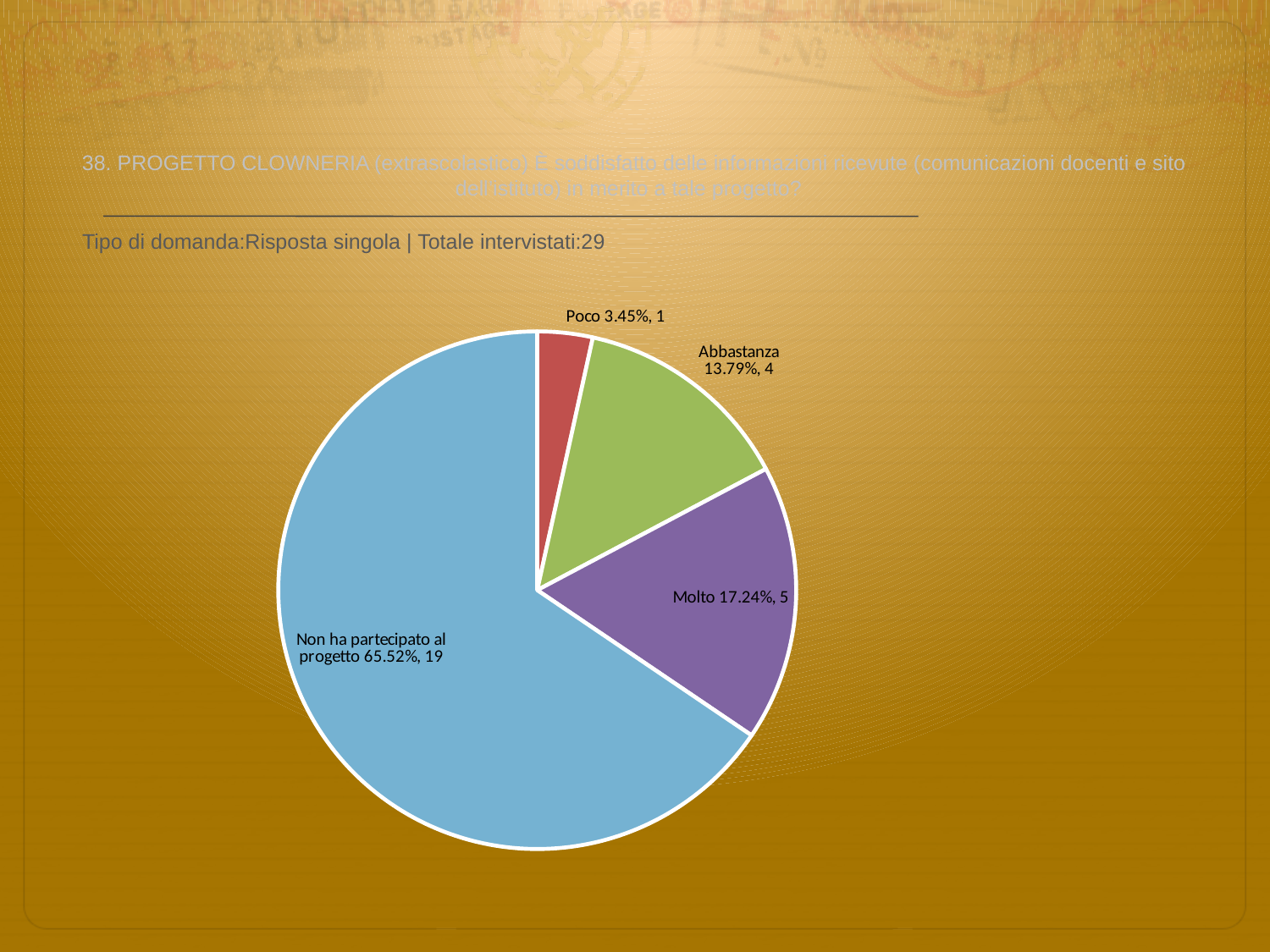
Which has more respondents, 'Molto' or 'Abbastanza'? Molto What colour is the 'Molto' slice? purple What is the total number of respondents across all slices? 29 What percentage is shown for the 'Molto' slice? 17.24% What is the difference in respondent count between 'Non ha partecipato al progetto' and 'Molto'? 14 Which category has the smallest slice of the pie? Poco How many respondents answered 'Poco'? 1 How many respondents are shown for 'Abbastanza'? 4 What kind of chart is shown on the slide? pie chart Which category has the largest slice of the pie? Non ha partecipato al progetto What percentage is shown for 'Non ha partecipato al progetto'? 65.52% How many slices does the pie chart have? 4